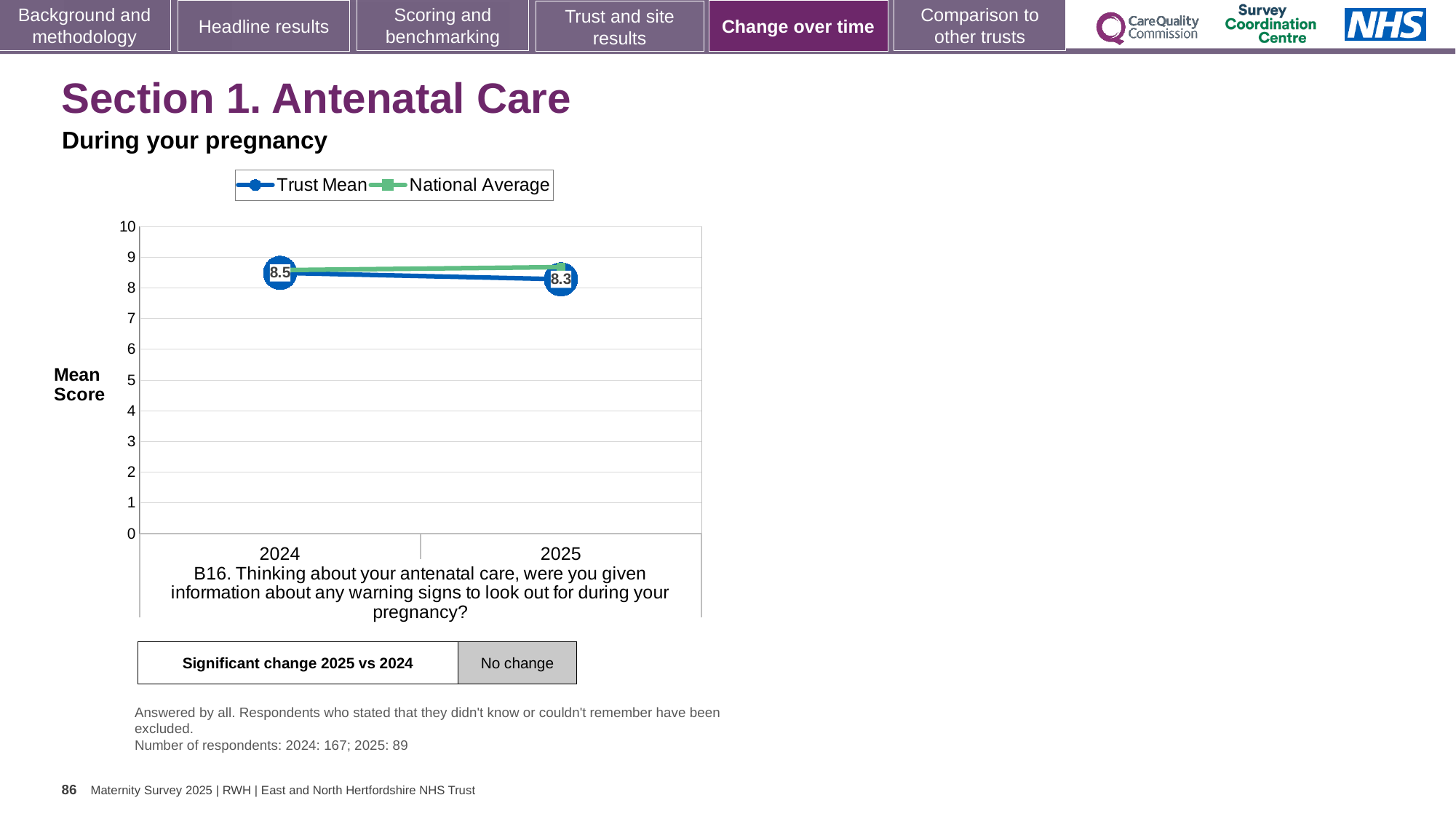
What kind of chart is shown on the slide? line chart What is the Trust Mean score for 2025? 8.3 Does the Trust Mean rise or fall from 2024 to 2025? fall What is the Trust Mean score for 2024? 8.5 By how much did the Trust Mean score change from 2024 to 2025? 0.2 In 2025, which is higher: the Trust Mean or the National Average? National Average How many years are plotted on the x axis? 2 Is the National Average value for 2025 greater or less than 8? greater What is the label on the y axis of the chart? Mean Score How many series does the legend list? 2 What are the two series named in the legend? Trust Mean and National Average Which year has the higher Trust Mean score, 2024 or 2025? 2024